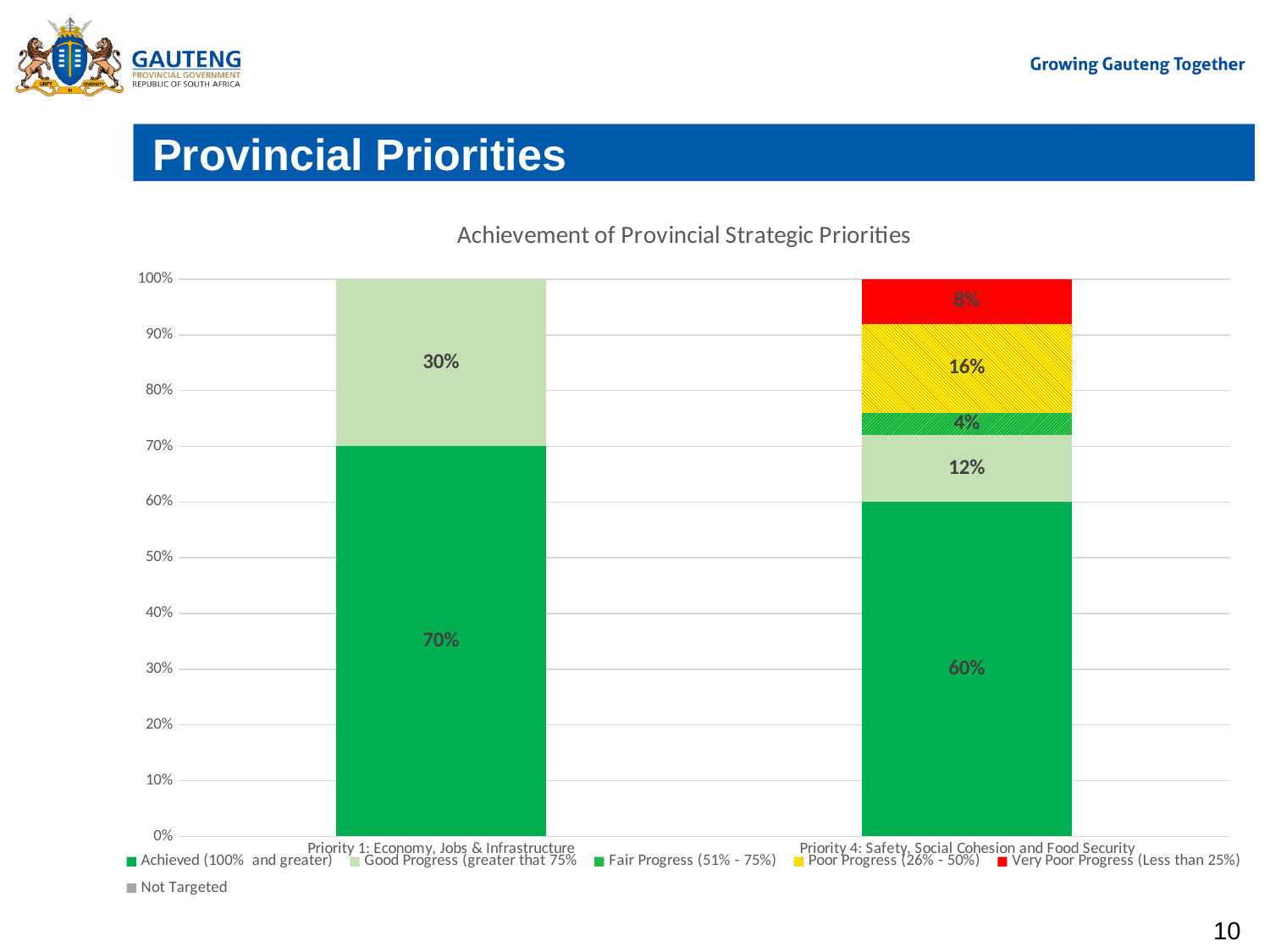
What is the title of the chart? Achievement of Provincial Strategic Priorities What is the Poor Progress (26% - 50%) value for Priority 4: Safety, Social Cohesion and Food Security? 16% What is the Good Progress (greater that 75%) value for Priority 4: Safety, Social Cohesion and Food Security? 12% What is the difference between the Achieved values for Priority 1 and Priority 4? 10% What is the Fair Progress (51% - 75%) value for Priority 4: Safety, Social Cohesion and Food Security? 4% What kind of chart is shown on the slide? Stacked bar chart How many priorities (categories) are shown on the x axis? 2 What is the Achieved (100% and greater) value for Priority 1: Economy, Jobs & Infrastructure? 70% What is the Very Poor Progress (Less than 25%) value for Priority 4: Safety, Social Cohesion and Food Security? 8% How many series does the legend list? 6 Which priority has the higher Achieved (100% and greater) value? Priority 1: Economy, Jobs & Infrastructure Which is larger: the Good Progress value for Priority 1 or the Good Progress value for Priority 4? Priority 1